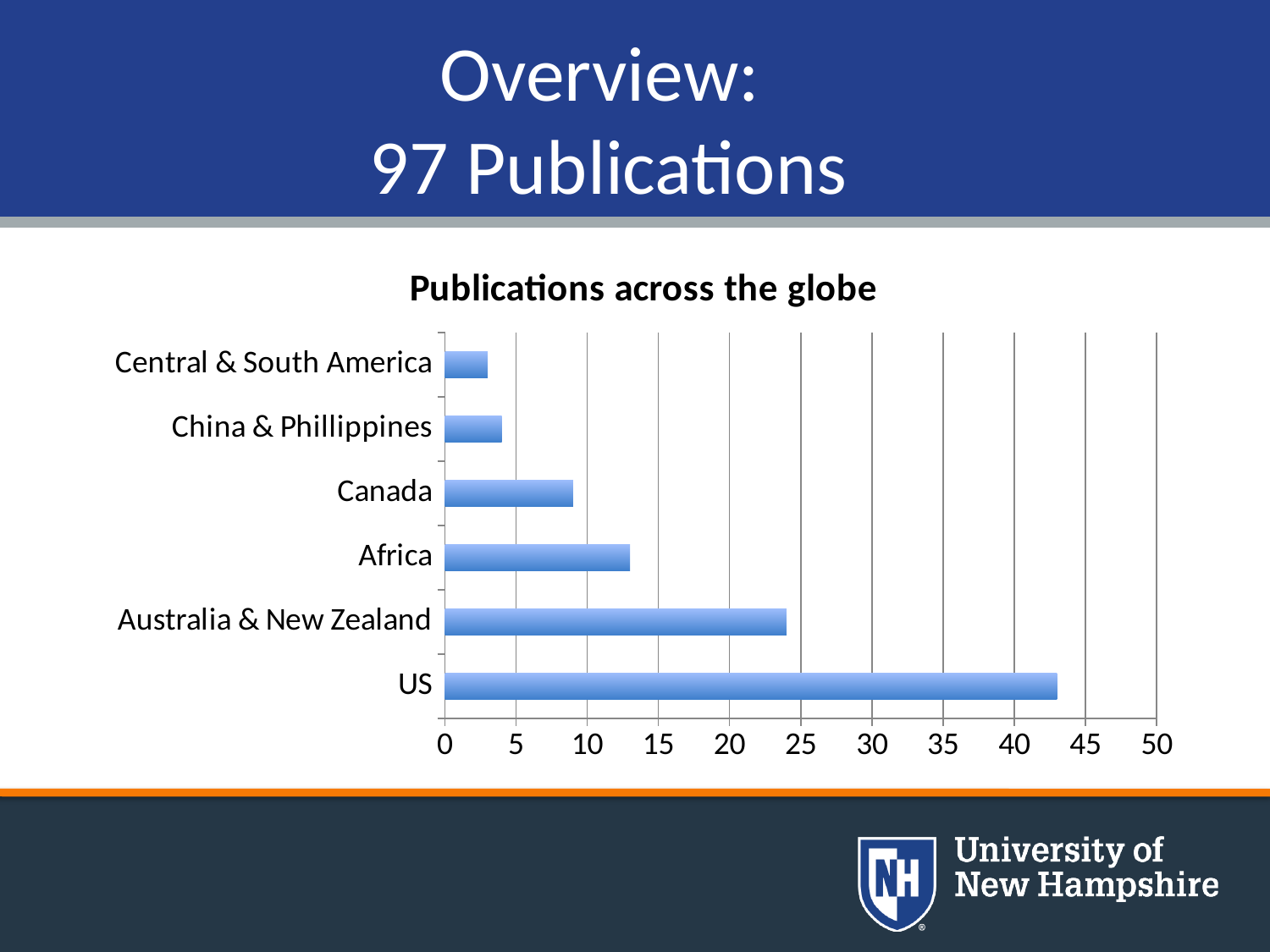
What kind of chart is shown on the slide? bar chart Is the value for US greater or less than 40? greater How many categories are shown in the chart? 6 Is the value for Central & South America greater or less than 5? less Is the value for Canada greater or less than 10? less What is the title of the chart? Publications across the globe Which has more publications, US or Australia & New Zealand? US Which has more publications, Africa or Canada? Africa Which category has the highest number of publications? US